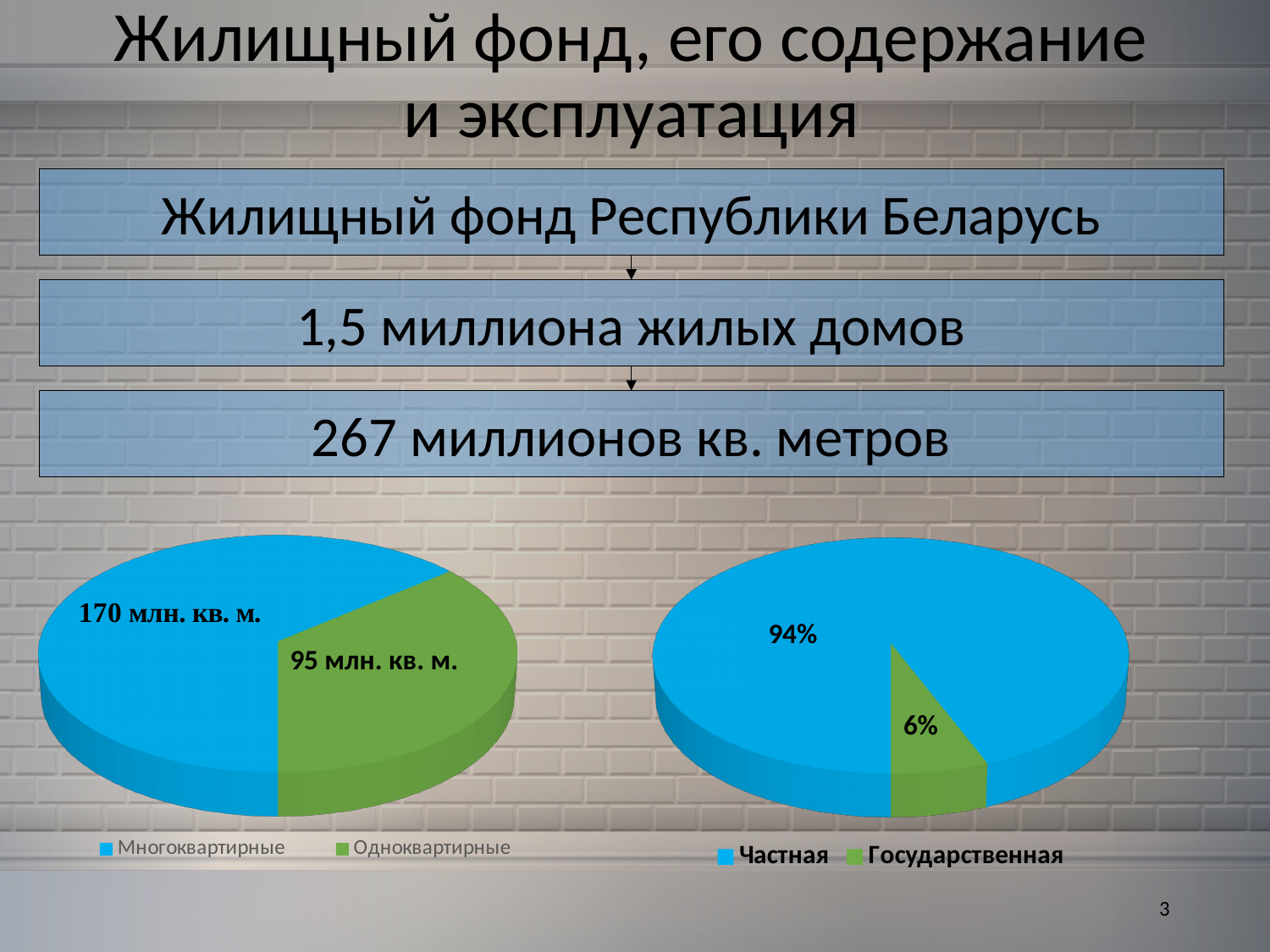
What kind of chart is the right chart on the slide? pie chart In the right pie chart, what share is labelled for Частная? 94% In the left pie chart, what is the value for Одноквартирные? 95 млн. кв. м. In the right pie chart, what share is labelled for Государственная? 6% In the left pie chart, which category has the larger value? Многоквартирные What are the legend entries of the right pie chart? Частная, Государственная What kind of chart is the left chart on the slide? pie chart In the left pie chart, what is the value for Многоквартирные? 170 млн. кв. м. In the right pie chart, which category has the smallest share? Государственная How many slices does the left pie chart have? 2 In the left pie chart, what is the difference between the values for Многоквартирные and Одноквартирные? 75 млн. кв. м. In the right pie chart, which is larger: Частная or Государственная? Частная